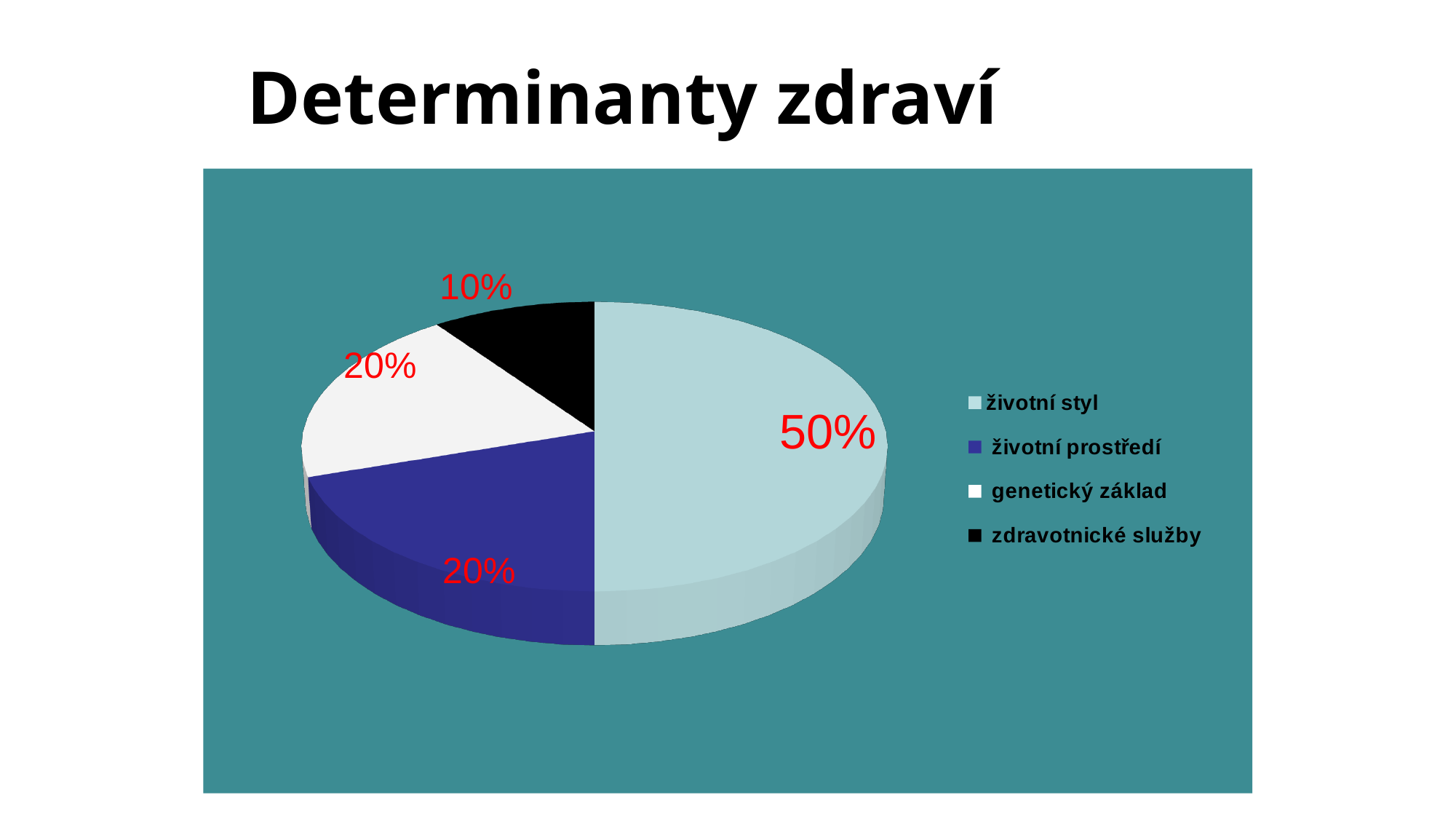
What is the title of the slide? Determinanty zdraví What share of the pie does zdravotnické služby have? 10% How many categories does the pie chart have? 4 What is the difference in percentage points between životní styl and zdravotnické služby? 40 What share of the pie does genetický základ have? 20% What colour is the slice for zdravotnické služby? black What share of the pie does životní styl have? 50% What share of the pie does životní prostředí have? 20% What kind of chart is shown on the slide? pie chart Which category has the smallest slice of the pie? zdravotnické služby Which category has the largest slice of the pie? životní styl Which is larger, the slice for životní styl or the slice for genetický základ? životní styl